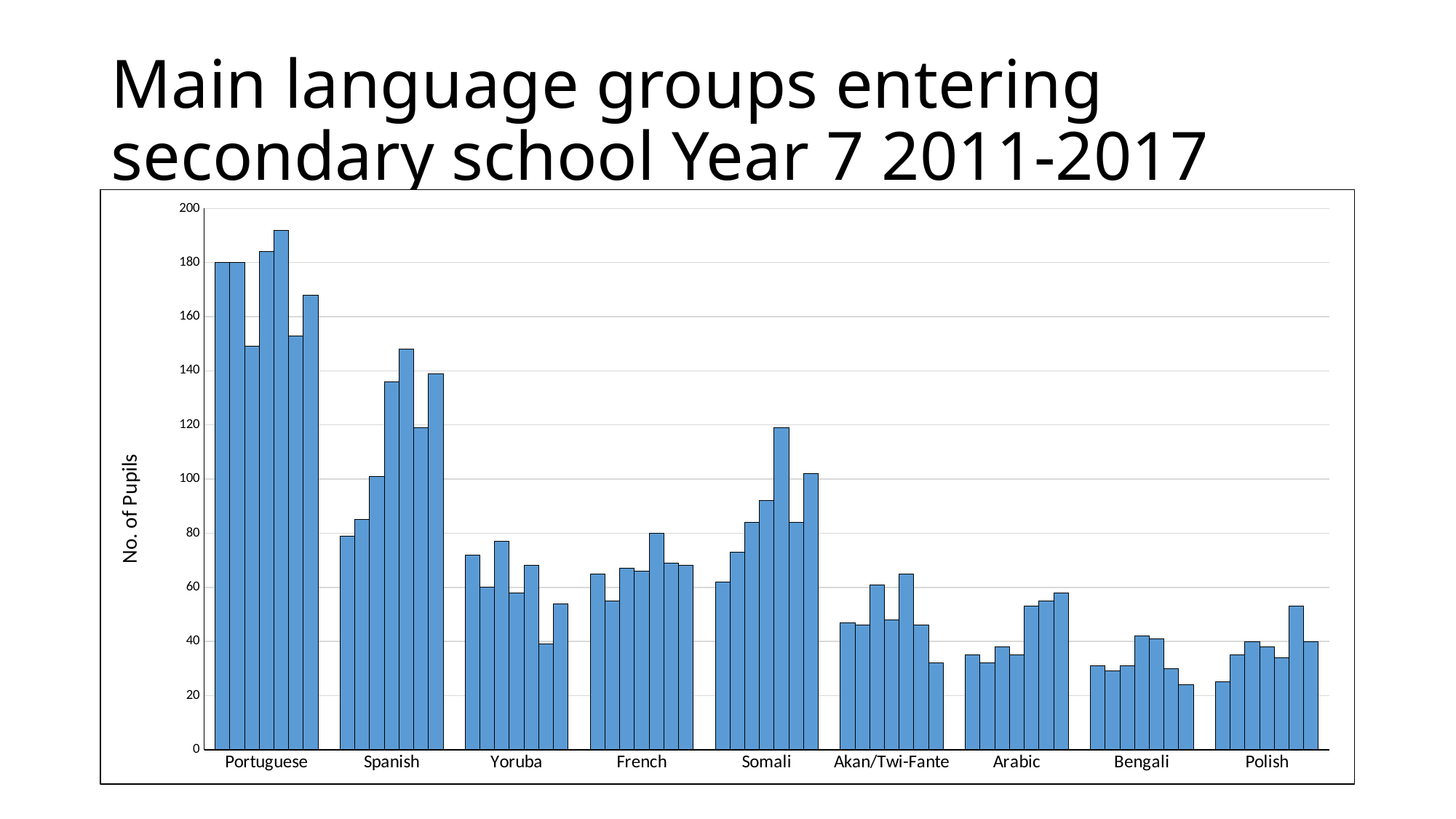
How many language groups are shown on the x axis of the chart? 9 Is the tallest bar for Yoruba greater or less than 80? less What kind of chart is shown on the slide? bar chart What is the label on the vertical axis of the chart? No. of Pupils Which language group has the tallest bar: Portuguese or Spanish? Portuguese Is the tallest bar for Somali greater or less than 100? greater What is the title of the chart on the slide? Main language groups entering secondary school Year 7 2011-2017 Which group has taller bars overall: Somali or Arabic? Somali Which language group has the tallest bar in the chart? Portuguese Are all the bars for Portuguese greater or less than 140? greater How many bars are plotted for each language group? 7